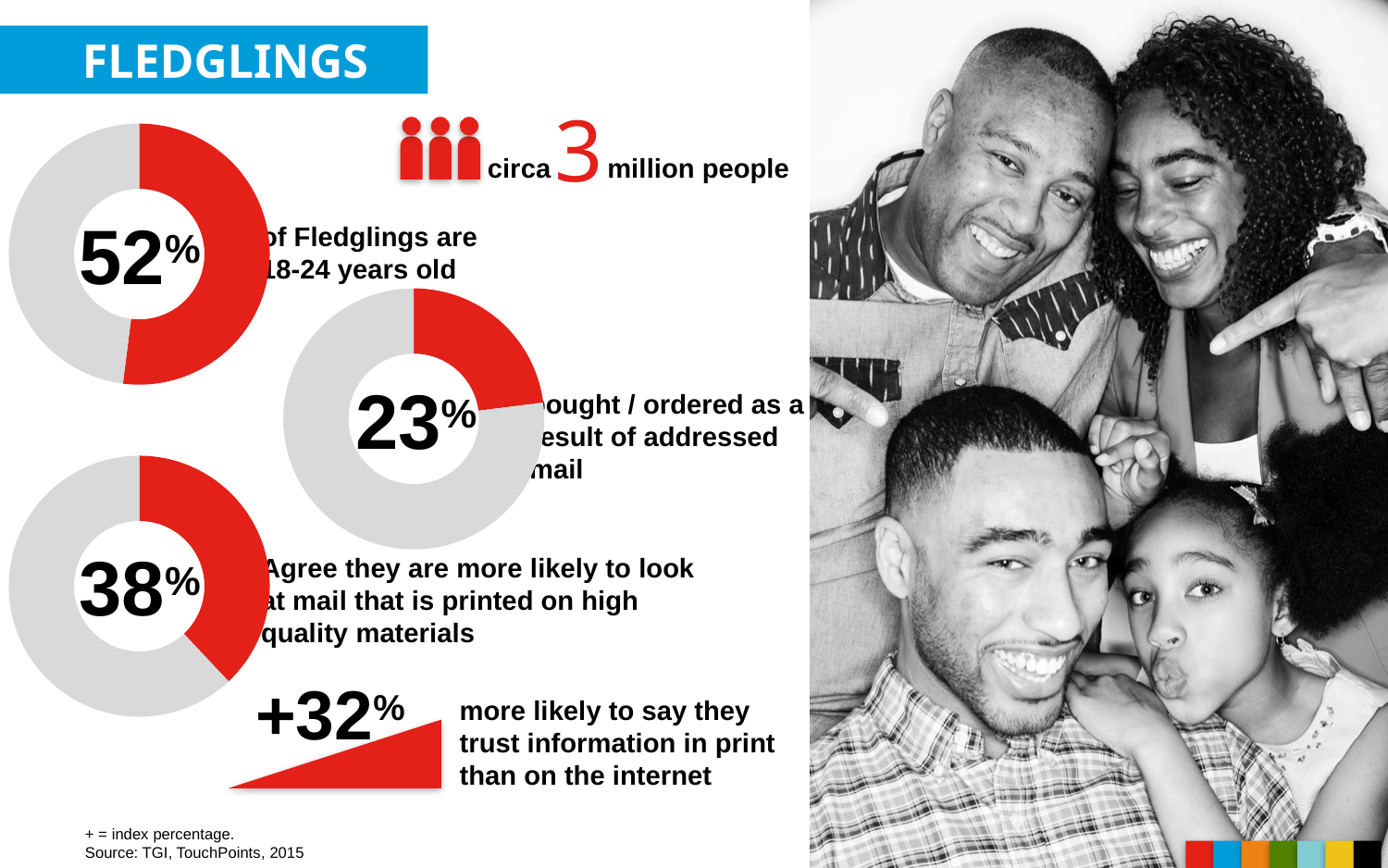
What is the difference between the 38% donut chart and the 23% donut chart? 15% What kind of chart is used to show the 52%, 23% and 38% figures on the slide? Donut chart What percentage is shown in the bottom-left donut chart for those who agree they are more likely to look at mail printed on high quality materials? 38% What colour is used for the highlighted segment in each donut chart? Red What is the difference between the 52% donut chart and the 38% donut chart? 14% In the middle donut chart, what share of the ring is filled in red? 23% Which of the three donut charts shows the lowest percentage? The middle one (23%) Which of the three donut charts shows the highest percentage? The top-left one (52%) What percentage is shown in the middle donut chart for those who bought / ordered as a result of addressed mail? 23% Which is larger: the percentage of Fledglings aged 18-24 or the percentage who bought / ordered as a result of addressed mail? Fledglings aged 18-24 (52%) What percentage is shown in the top-left donut chart for Fledglings who are 18-24 years old? 52% How many donut charts are on the slide? 3